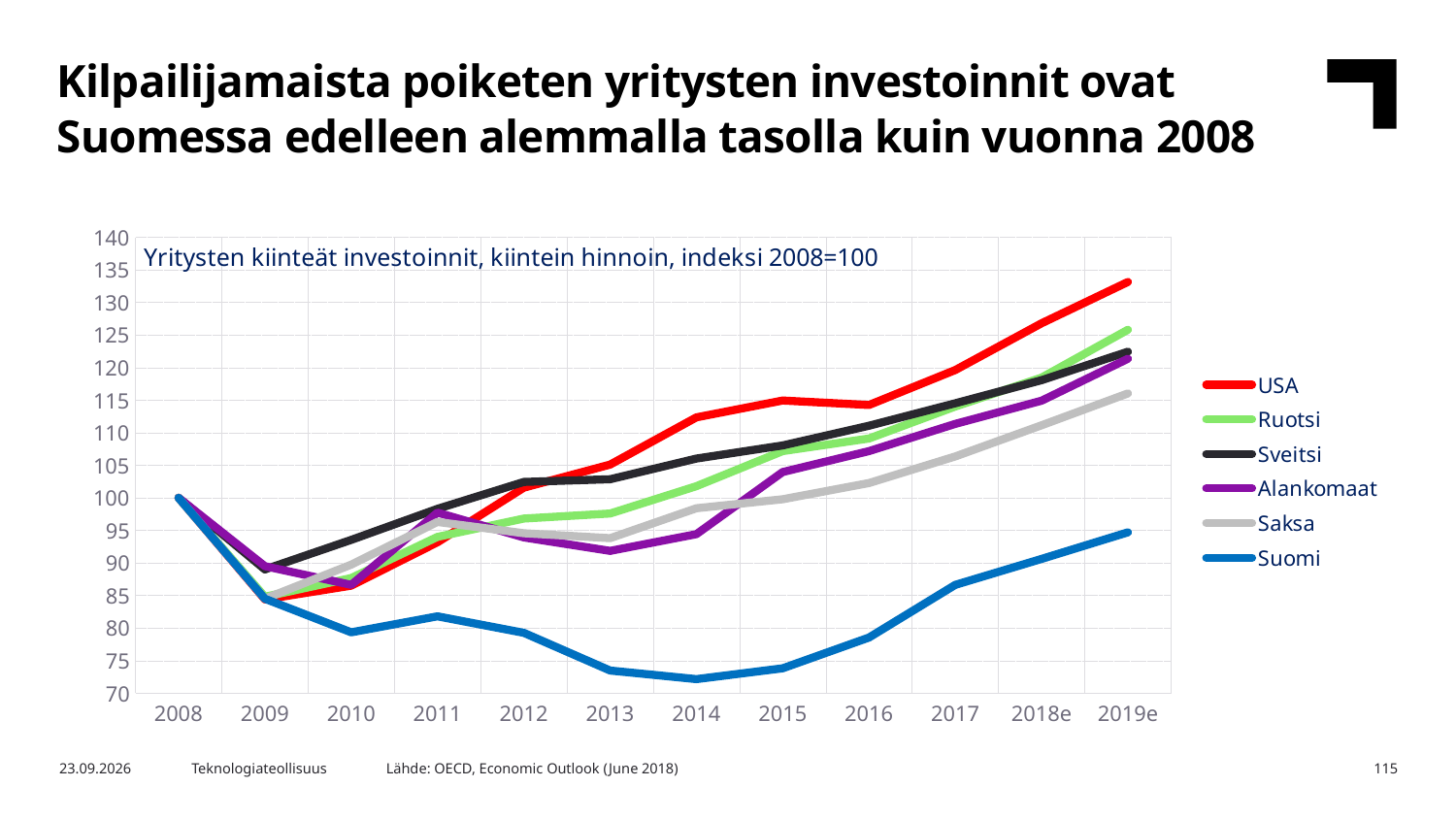
What kind of chart is shown on the slide? line chart How many series does the legend list? 6 How many years are shown on the x axis? 12 Which country has the highest value in 2019e? USA Is the value for Suomi in 2019e greater or less than 100? less Is the value for Suomi in 2014 greater or less than 75? less Which series is drawn in blue? Suomi Is the value for USA in 2019e greater or less than 130? greater Which country has the lowest value in 2019e? Suomi Does the value for Suomi rise or fall from 2008 to 2014? fall Which is larger in 2014, the value for USA or the value for Ruotsi? USA